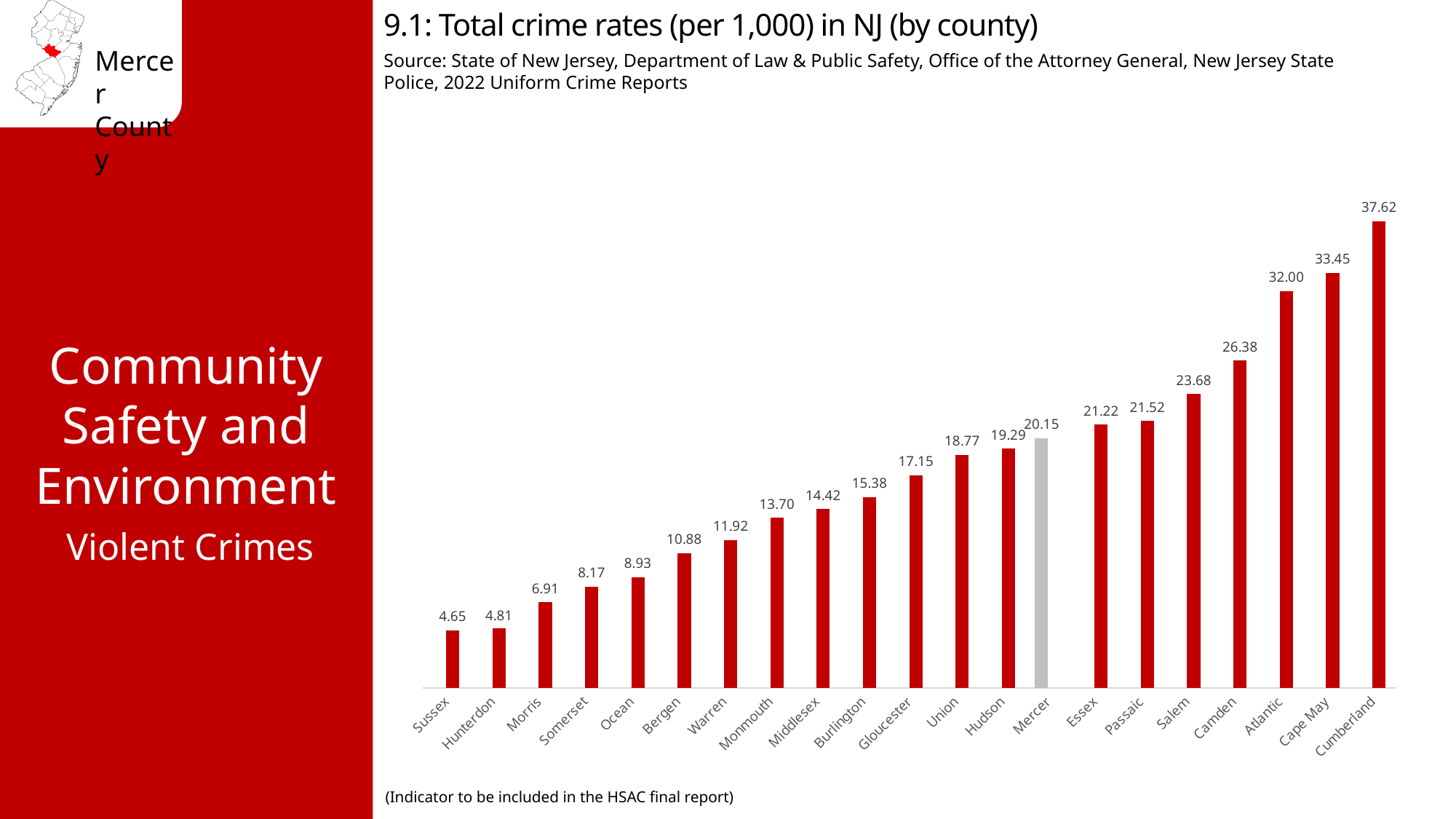
Which has a higher total crime rate, Camden or Salem? Camden How many counties are shown in the chart? 21 Which has a higher total crime rate, Essex or Union? Essex What is the difference between the crime rates of Cumberland and Sussex? 32.97 What kind of chart is shown on the slide? Bar chart Which county's bar is shown in grey rather than red? Mercer What is the total crime rate for Cumberland County? 37.62 Which county has the lowest total crime rate? Sussex What is the total crime rate for Bergen County? 10.88 What is the total crime rate for Mercer County? 20.15 Which county has the highest total crime rate? Cumberland What is the difference between the crime rates of Mercer and Hudson? 0.86